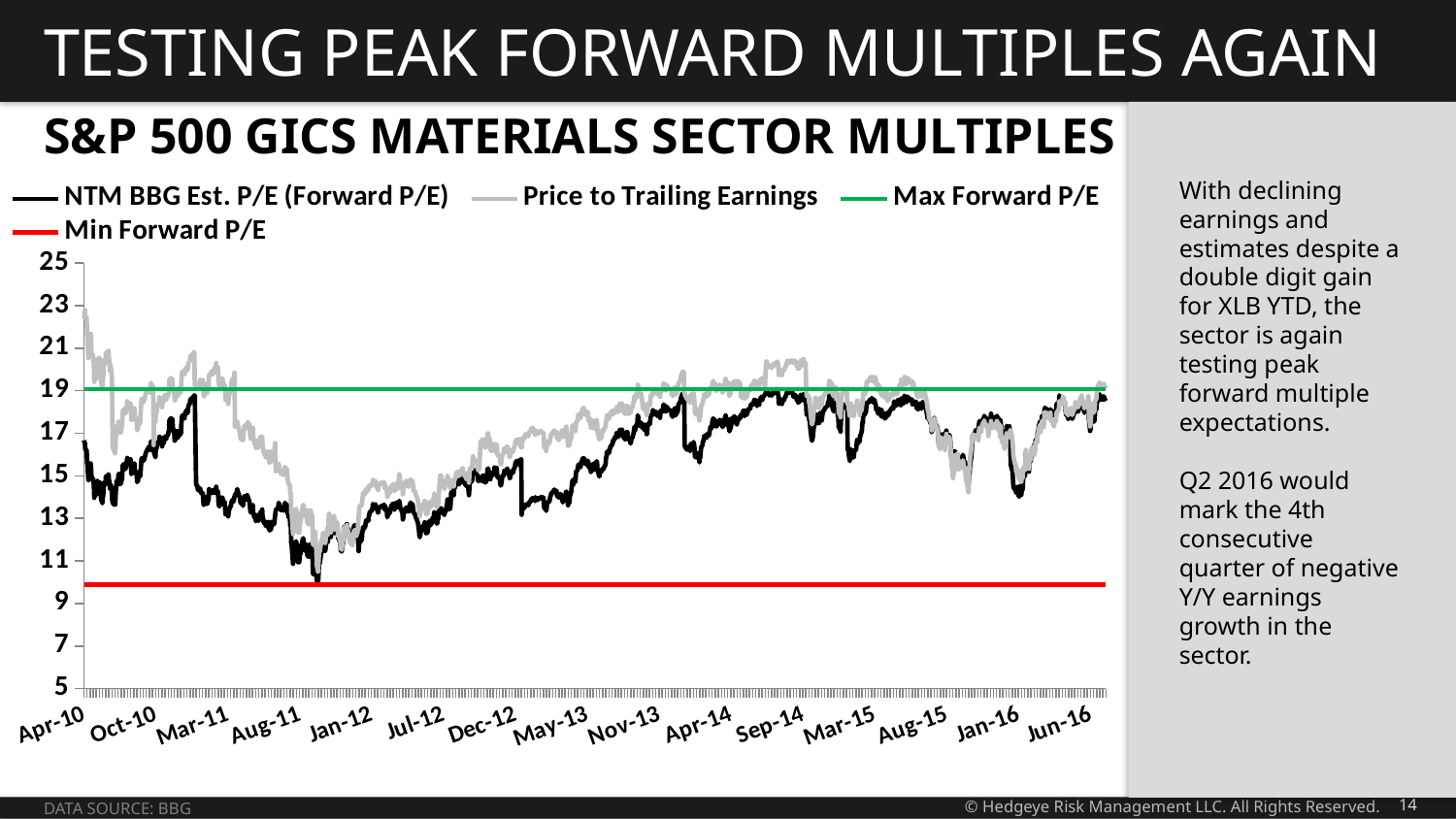
What value does the Max Forward P/E line sit at? 19 Around Jan-12, is the NTM BBG Est. P/E (Forward P/E) greater or less than 13? less What kind of chart is shown on the slide? line chart How many series does the legend list? 4 Is the Min Forward P/E line greater or less than 11? less How many date labels are shown on the x axis? 15 What colour is the Max Forward P/E line? green At Apr-10, which is higher: the Price to Trailing Earnings or the NTM BBG Est. P/E (Forward P/E)? Price to Trailing Earnings Does the NTM BBG Est. P/E (Forward P/E) generally rise or fall between Jan-12 and Sep-14? rise What is the title of the chart? S&P 500 GICS MATERIALS SECTOR MULTIPLES Is the Min Forward P/E line greater or less than 9? greater